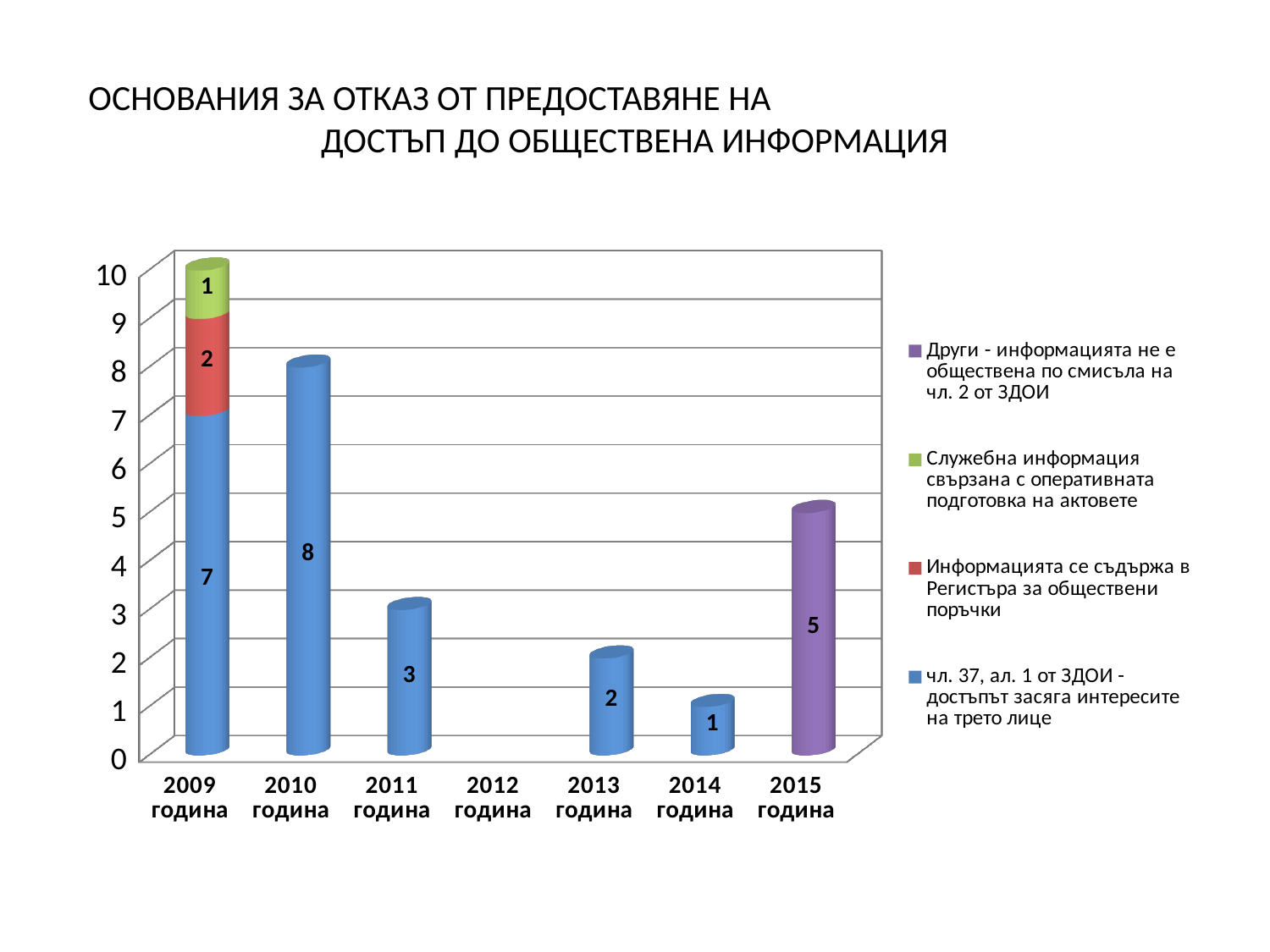
Which year shows no bar at all? 2012 година Which year has the tallest stacked bar? 2009 година What is the value for "Информацията се съдържа в Регистъра за обществени поръчки" in 2009 година? 2 Which year has the lowest non-zero bar? 2014 година What type of chart is shown on the slide? bar chart How many year categories are shown on the x axis? 7 Which is larger: the value for 2013 година or the value for 2015 година? 2015 година What is the total of the stacked bar for 2009 година? 10 What is the value for "чл. 37, ал. 1 от ЗДОИ - достъпът засяга интересите на трето лице" in 2010 година? 8 What is the difference between the values for "чл. 37, ал. 1 от ЗДОИ" in 2010 година and 2011 година? 5 How many series does the legend list? 4 What is the value for "Други - информацията не е обществена по смисъла на чл. 2 от ЗДОИ" in 2015 година? 5